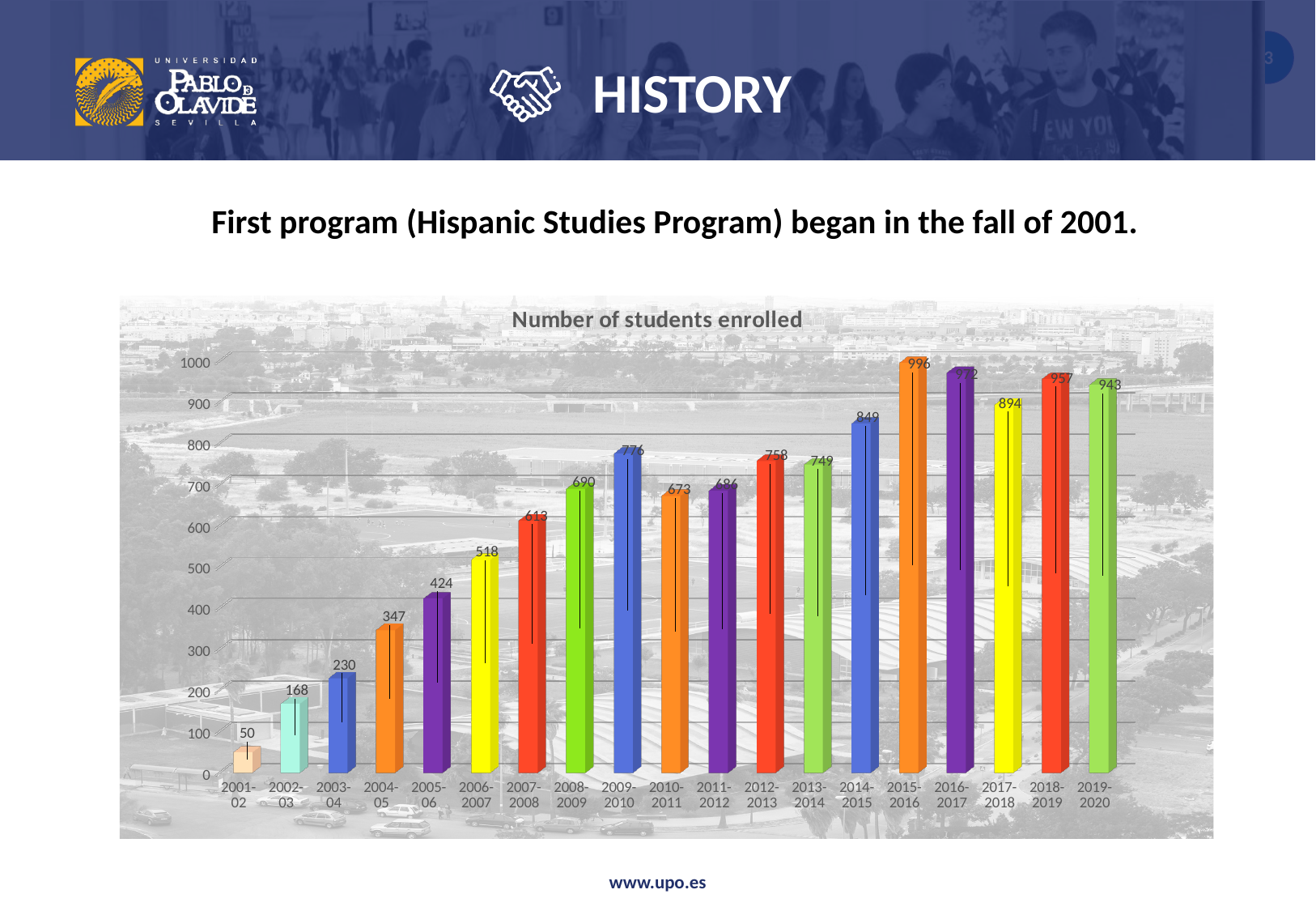
Do the enrollment numbers generally rise or fall from 2001-02 to 2015-2016? Rise How many academic years are shown on the x axis of the chart? 19 Is the value for 2016-2017 greater or less than 900? greater How many students were enrolled in 2017-2018? 894 Which academic year has the lowest number of students enrolled? 2001-02 Which year had more students enrolled, 2009-2010 or 2010-2011? 2009-2010 How many students were enrolled in 2006-2007? 518 What type of chart is shown on the slide? Bar chart How many students were enrolled in 2001-02? 50 What is the title of the chart? Number of students enrolled Which academic year has the highest number of students enrolled? 2015-2016 What is the difference in students enrolled between 2014-2015 and 2013-2014? 100